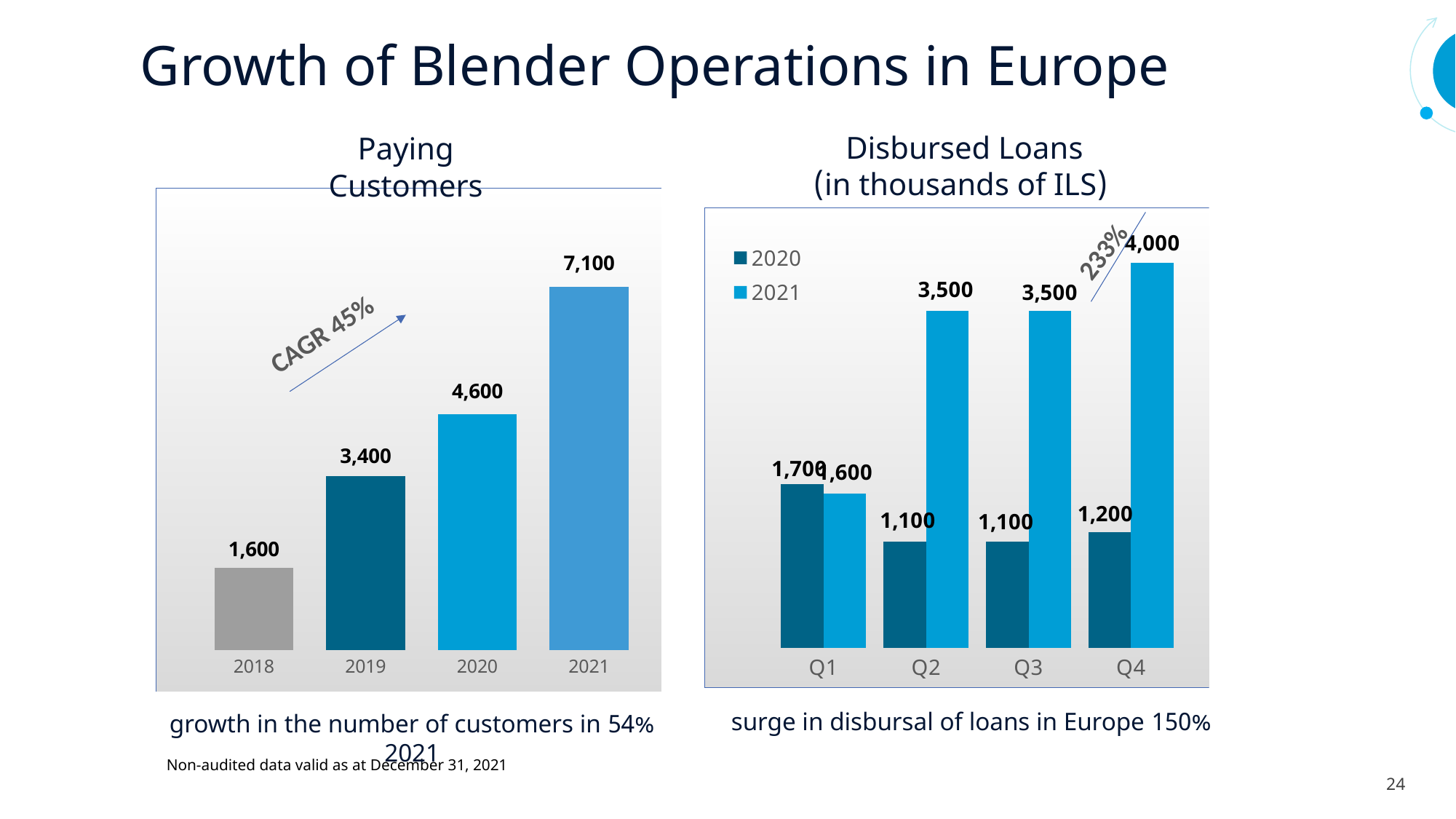
In the Disbursed Loans chart, how many series does the legend list? 2 What kind of chart is the Disbursed Loans chart? bar chart In the Paying Customers chart, do the values rise or fall from 2018 to 2021? rise In the Disbursed Loans chart, what is the 2020 value for Q1? 1,700 In the Disbursed Loans chart, which is larger for Q2: the 2020 value or the 2021 value? 2021 In the Paying Customers chart, how many years are shown on the x axis? 4 In the Disbursed Loans chart, what is the 2021 value for Q4? 4,000 In the Paying Customers chart, what is the value for 2018? 1,600 In the Disbursed Loans chart, which quarter has the highest 2021 value? Q4 In the Paying Customers chart, what is the difference between the 2021 and 2020 values? 2,500 In the Paying Customers chart, what is the value for 2021? 7,100 In the Paying Customers chart, which year has the lowest value? 2018